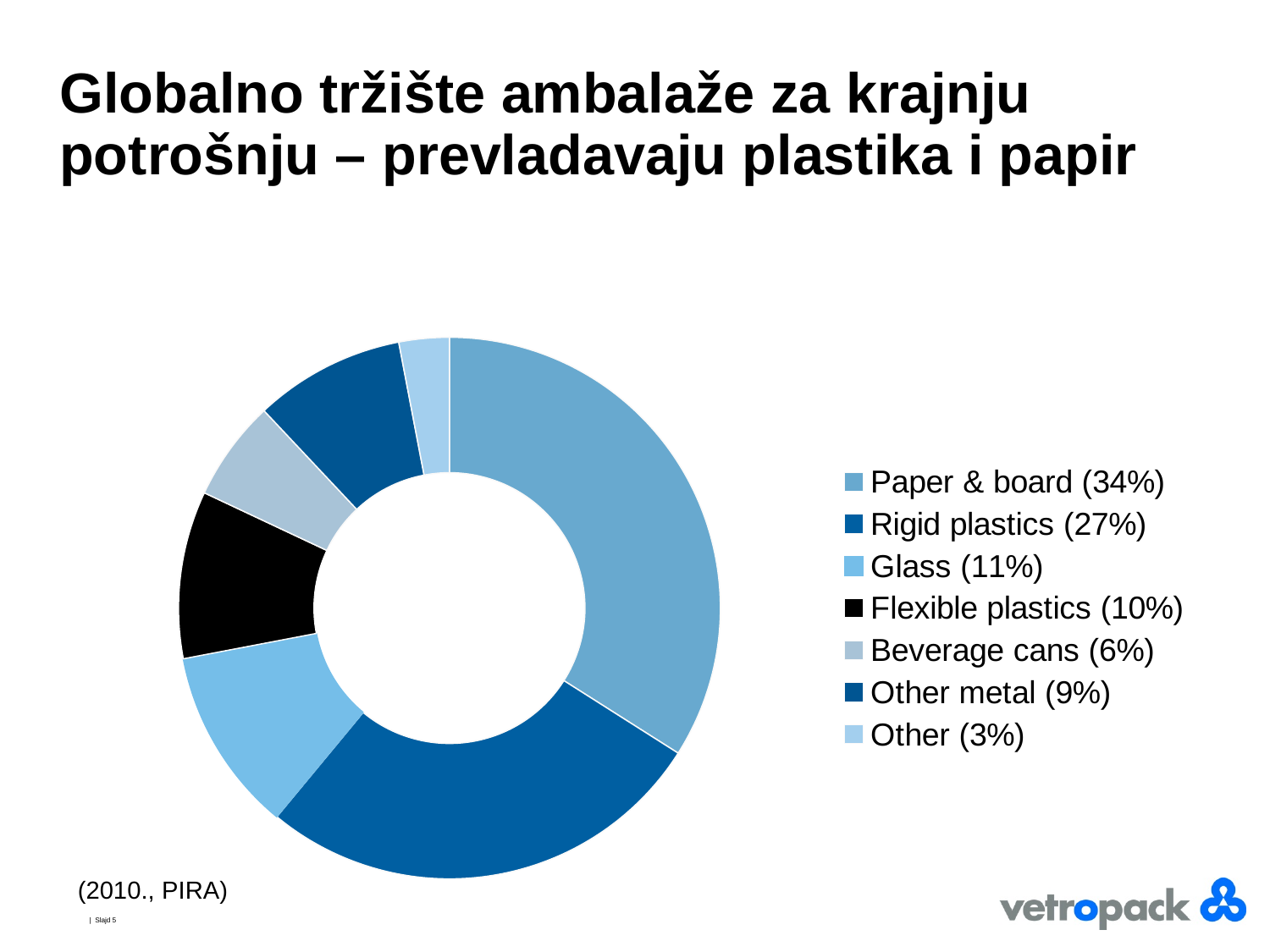
Which category is shown in black in the chart? Flexible plastics What share does Glass hold in the chart? 11% What is the combined share of Rigid plastics and Flexible plastics? 37% What is the difference in share between Paper & board and Rigid plastics? 7 percentage points Which category has the smallest share in the chart? Other Which has a larger share, Glass or Other metal? Glass What is the difference in share between Other metal and Beverage cans? 3 percentage points How many categories does the chart show? 7 Which category has the largest share in the chart? Paper & board What kind of chart is shown on the slide? Doughnut (pie) chart What share does Flexible plastics hold in the chart? 10% What share of the global consumer packaging market does Paper & board hold? 34%